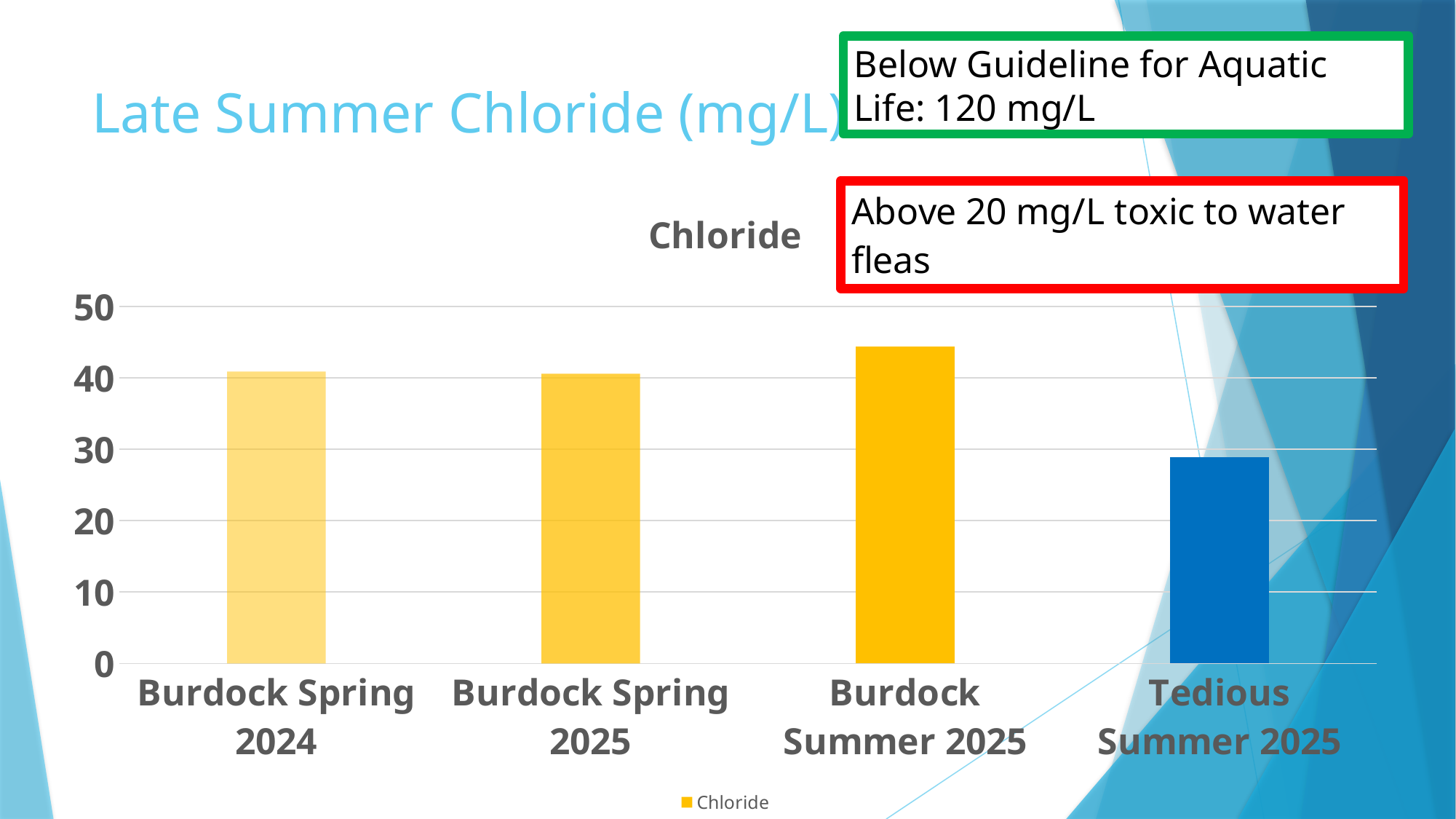
Is the value for Burdock Spring 2025 greater or less than 50? less How many series does the chart's legend list? 1 Which category has the lowest chloride value? Tedious Summer 2025 What is the title of the chart? Chloride Which category has the highest chloride value? Burdock Summer 2025 Which is larger, the value for Burdock Spring 2024 or the value for Tedious Summer 2025? Burdock Spring 2024 How many categories are shown on the x axis of the chart? 4 Is the value for Tedious Summer 2025 greater or less than 20? greater Which is larger, the value for Burdock Summer 2025 or the value for Tedious Summer 2025? Burdock Summer 2025 Which category's bar is coloured blue rather than yellow? Tedious Summer 2025 Is the value for Burdock Summer 2025 greater or less than 40? greater What kind of chart is shown on the slide? bar chart